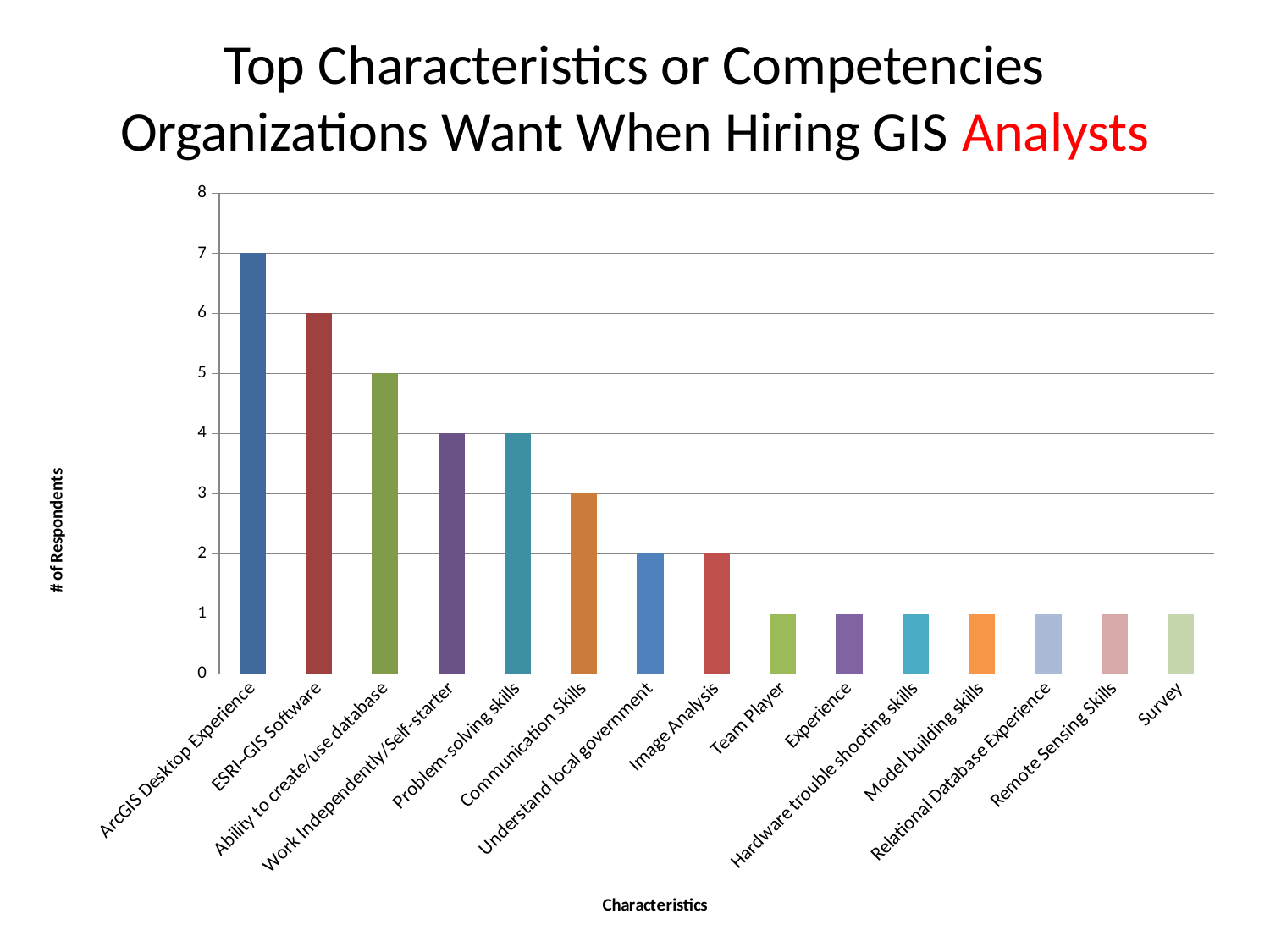
Which characteristic has the highest number of respondents? ArcGIS Desktop Experience What is the difference in respondents between ArcGIS Desktop Experience and Ability to create/use database? 2 Is the value for ESRI-GIS Software greater or less than 5? greater What is the label of the horizontal axis? Characteristics How many respondents are shown for Communication Skills? 3 Which has more respondents, Problem-solving skills or Understand local government? Problem-solving skills How many respondents are shown for ESRI-GIS Software? 6 How many respondents are shown for ArcGIS Desktop Experience? 7 Do the values generally rise or fall moving from left to right along the x axis? Fall What is the label of the vertical axis? # of Respondents What kind of chart is shown on the slide? Bar chart How many characteristics are plotted on the chart? 15